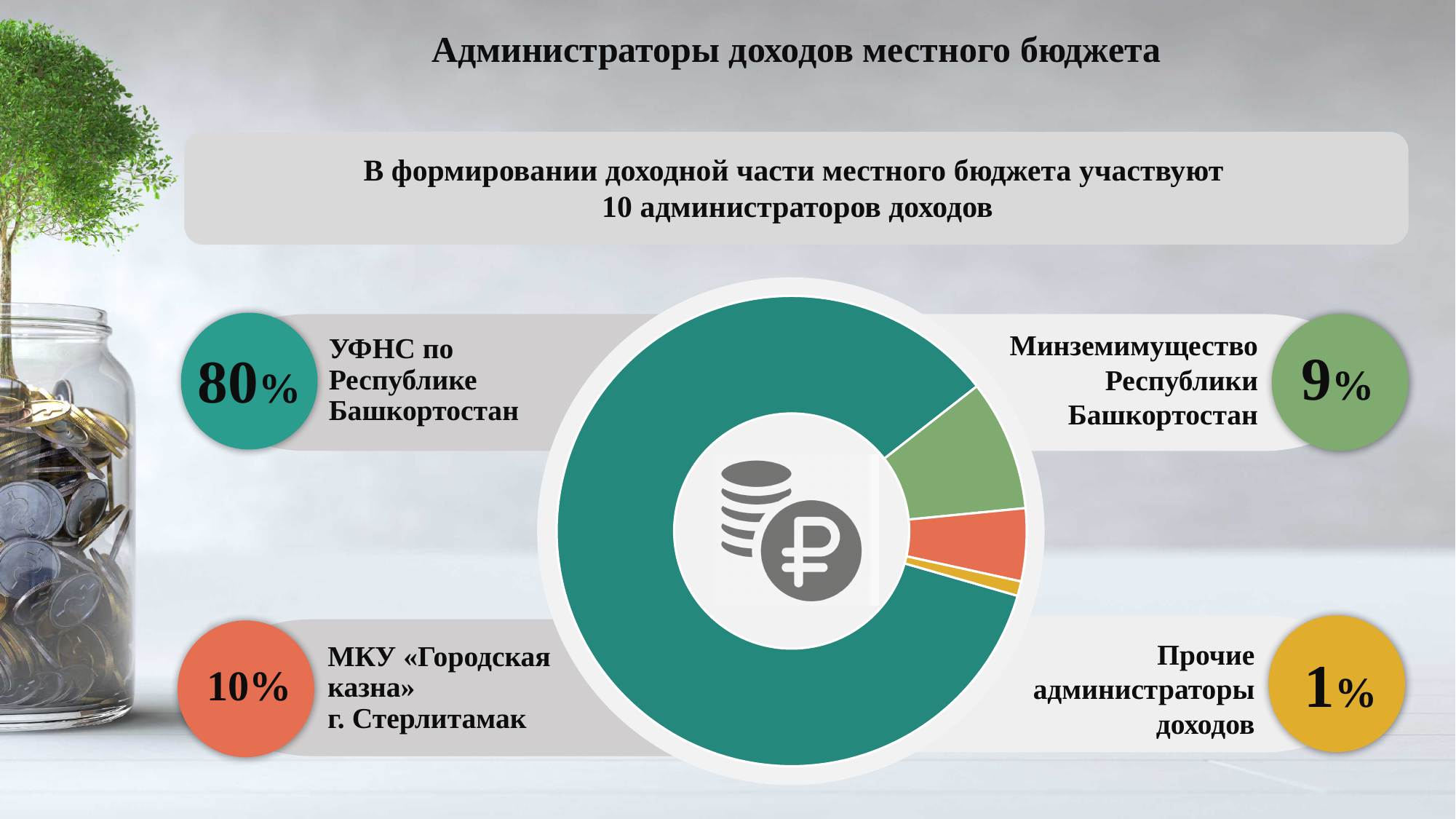
How many segments does the chart have? 4 What is the difference between the shares of УФНС по Республике Башкортостан and МКУ «Городская казна» г. Стерлитамак? 70% What share is shown for МКУ «Городская казна» г. Стерлитамак? 10% Which has a larger share: Минземимущество Республики Башкортостан or МКУ «Городская казна» г. Стерлитамак? МКУ «Городская казна» г. Стерлитамак What share of local budget revenue is administered by УФНС по Республике Башкортостан? 80% What is the combined share of Минземимущество Республики Башкортостан and Прочие администраторы доходов? 10% What share is shown for Минземимущество Республики Башкортостан? 9% What type of chart is shown on the slide? Pie chart (donut) Which revenue administrator has the largest share in the chart? УФНС по Республике Башкортостан What share is shown for Прочие администраторы доходов? 1% What colour is the segment representing МКУ «Городская казна» г. Стерлитамак? Orange Which category has the smallest share in the chart? Прочие администраторы доходов